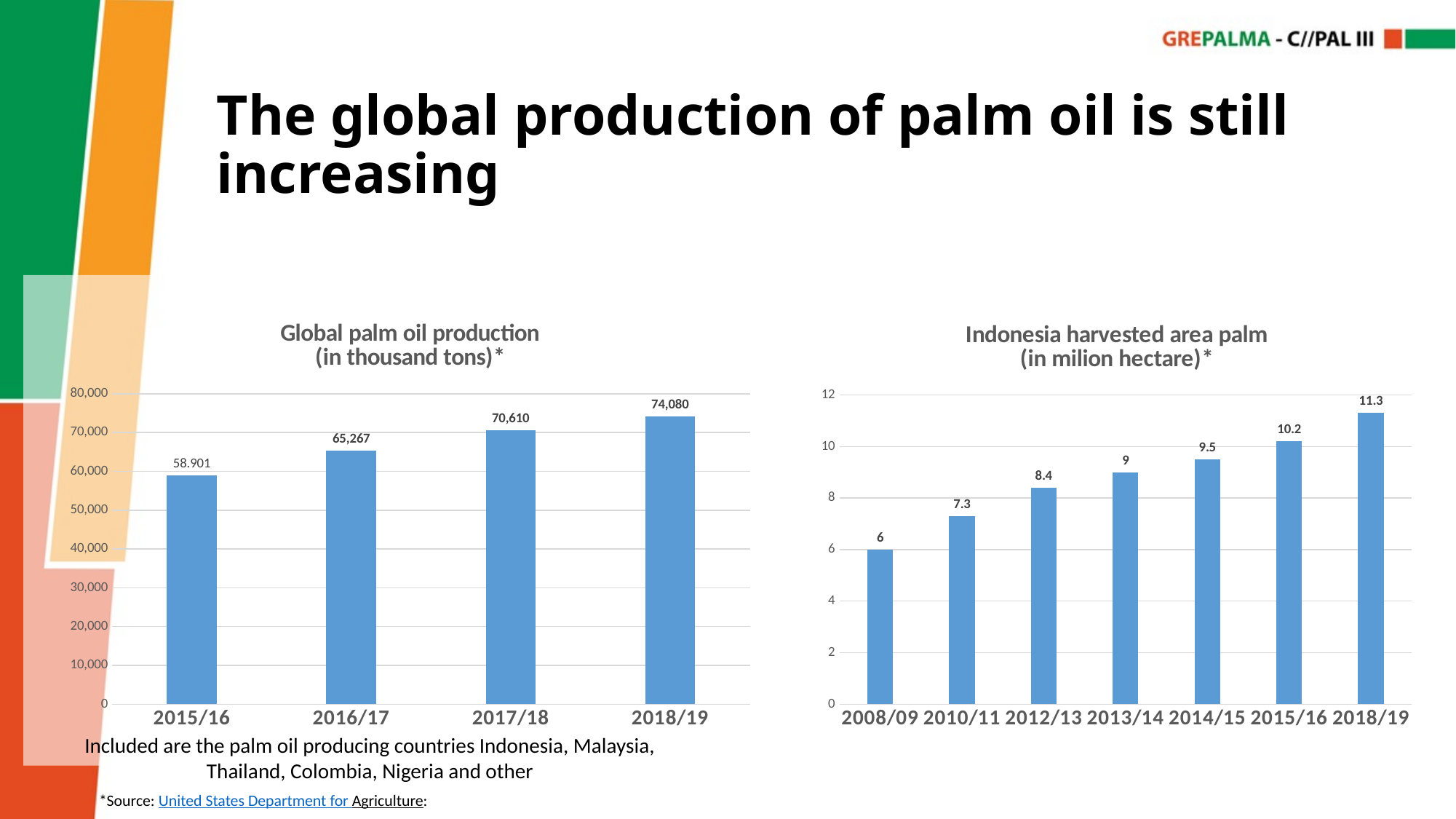
In the 'Indonesia harvested area palm (in milion hectare)' chart, which year has the highest value? 2018/19 In the 'Global palm oil production (in thousand tons)' chart, how many years are shown? 4 In the 'Indonesia harvested area palm (in milion hectare)' chart, how many years are shown? 7 In the 'Global palm oil production (in thousand tons)' chart, which year has the lowest production? 2015/16 In the 'Global palm oil production (in thousand tons)' chart, what is the value for 2018/19? 74,080 What type of chart is the 'Indonesia harvested area palm (in milion hectare)' chart? bar chart In the 'Indonesia harvested area palm (in milion hectare)' chart, what is the value for 2010/11? 7.3 In the 'Global palm oil production (in thousand tons)' chart, what is the difference between the 2018/19 and 2017/18 values? 3,470 In the 'Indonesia harvested area palm (in milion hectare)' chart, what is the value for 2013/14? 9 In the 'Global palm oil production (in thousand tons)' chart, what is the value for 2016/17? 65,267 In the 'Global palm oil production (in thousand tons)' chart, do the values rise or fall from 2015/16 to 2018/19? rise In the 'Indonesia harvested area palm (in milion hectare)' chart, what is the difference between the 2018/19 and 2008/09 values? 5.3